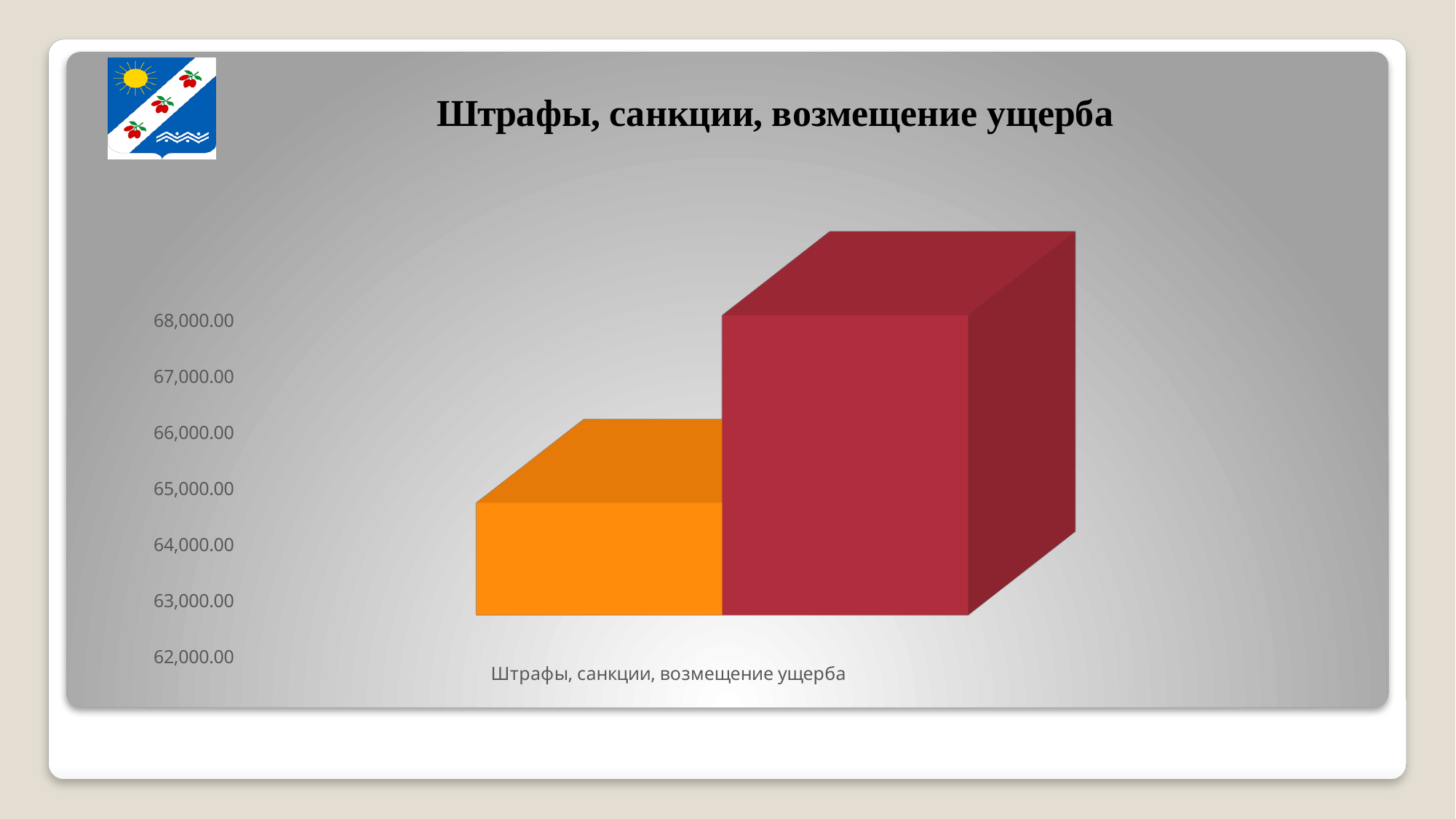
What kind of chart is shown on the slide? bar chart What is the title of the chart? Штрафы, санкции, возмещение ущерба Is the value of the orange bar greater or less than 66,000.00? less How many bars are plotted in the chart? 2 What is the lowest value shown on the vertical axis? 62,000.00 Which bar is taller, the orange bar or the red bar? the red bar Which bar shows the highest value? the red bar Is the value of the red bar greater or less than 66,000.00? greater Which bar shows the lowest value? the orange bar What is the label shown on the category axis below the bars? Штрафы, санкции, возмещение ущерба Is the value of the red bar greater or less than 67,000.00? greater